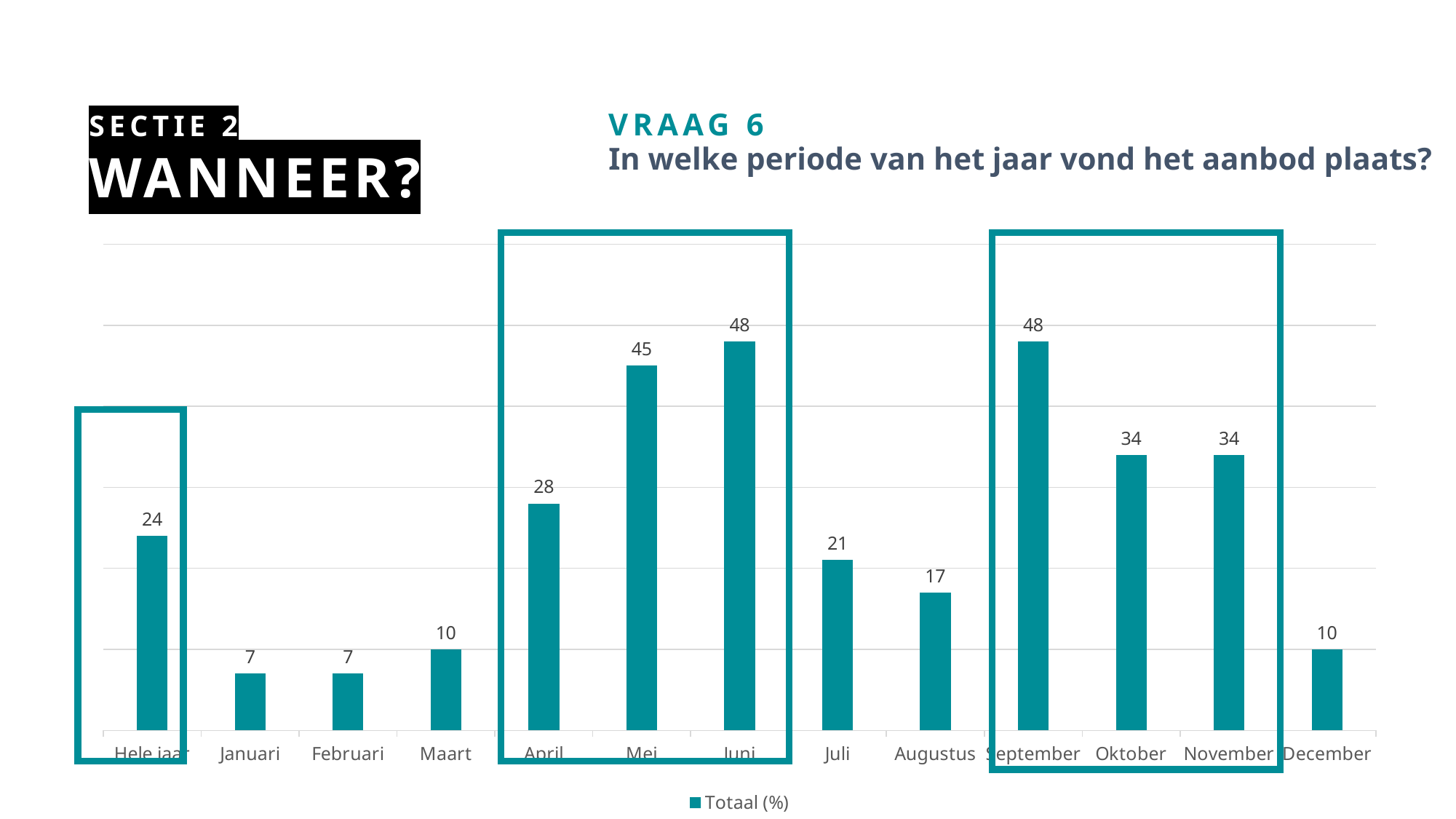
Which of April, Mei and Juni has the highest value? Juni What is the value for Hele jaar? 24 How many series does the legend list? 1 What kind of chart is shown on the slide? Bar chart What is the difference between the values for Juni and April? 20 What is the value for Augustus? 17 How many categories are shown on the x axis? 13 What is the value for Oktober? 34 Which is larger, the value for Juli or the value for Maart? Juli What is the value for Mei? 45 What is the legend entry of the chart? Totaal (%) Which of Juli, Augustus and September has the lowest value? Augustus